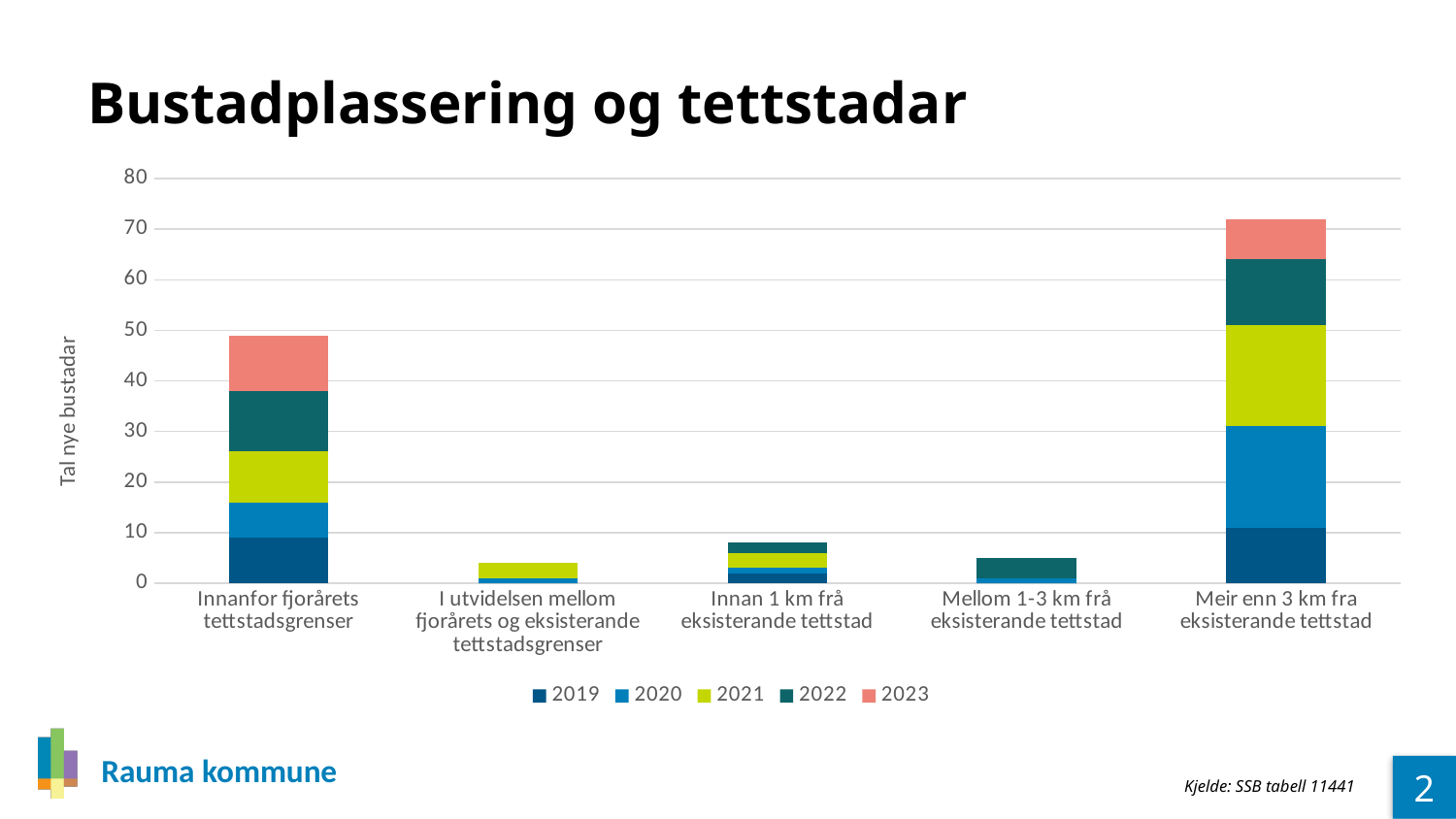
Which has a larger total: 'Innan 1 km frå eksisterande tettstad' or 'Mellom 1-3 km frå eksisterande tettstad'? Innan 1 km frå eksisterande tettstad What is the title of the chart slide? Bustadplassering og tettstadar Is the total for 'Innanfor fjorårets tettstadsgrenser' greater or less than 40? greater Is the total for 'I utvidelsen mellom fjorårets og eksisterande tettstadsgrenser' greater or less than 10? less How many categories are shown on the x axis of the chart? 5 Which has a larger total: 'Innanfor fjorårets tettstadsgrenser' or 'Meir enn 3 km fra eksisterande tettstad'? Meir enn 3 km fra eksisterande tettstad Which category has the highest total number of new dwellings? Meir enn 3 km fra eksisterande tettstad What kind of chart is shown on the slide? Stacked bar chart Is the total for 'Meir enn 3 km fra eksisterande tettstad' greater or less than 60? greater How many series does the legend list? 5 What is the title of the y axis? Tal nye bustadar